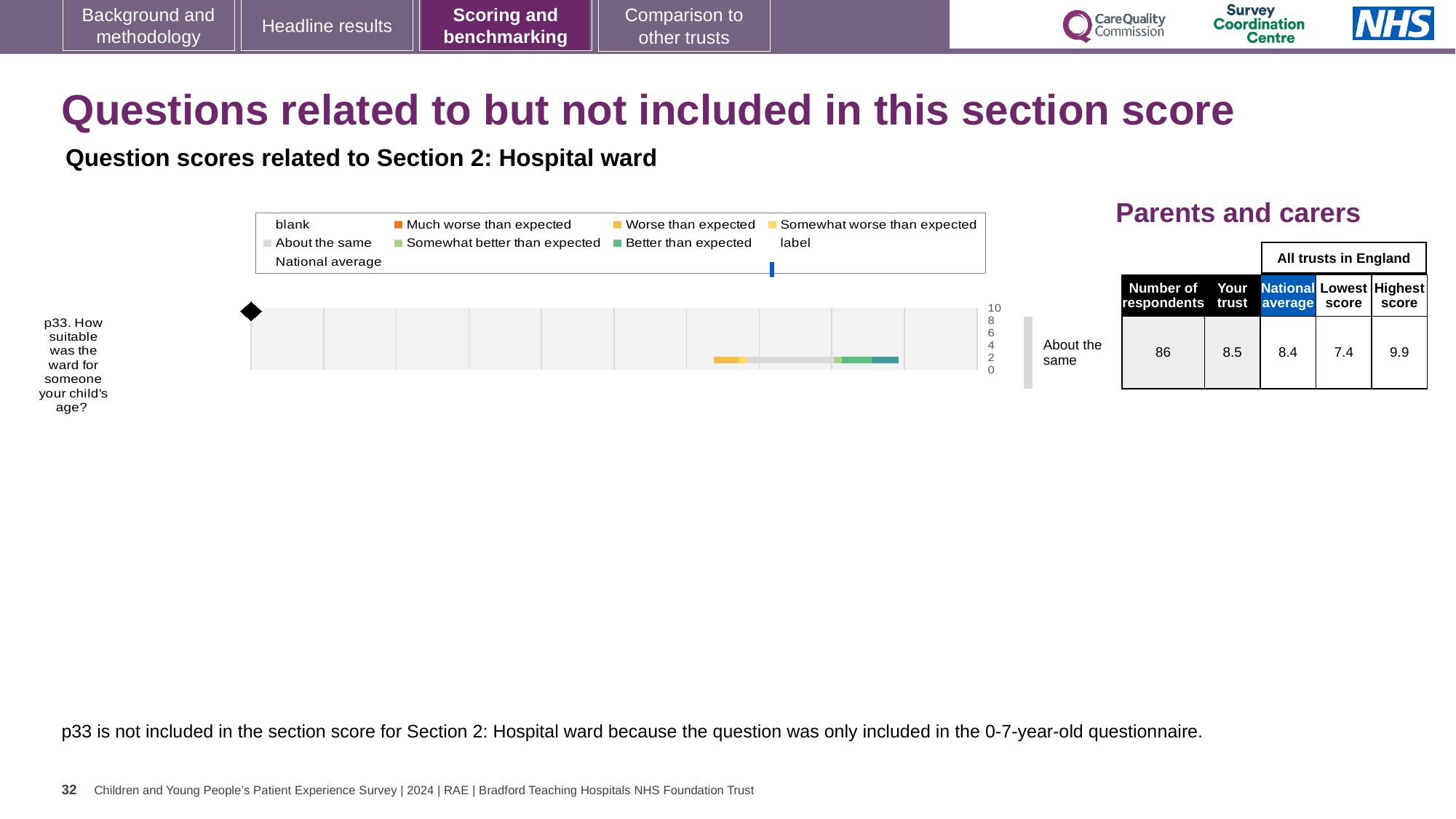
What is the highest score among all trusts in England for p33? 9.9 What is the 'Your trust' score for p33 in the Parents and carers table? 8.5 Which question is plotted in the chart? p33. How suitable was the ward for someone your child's age? What is the difference between the highest and lowest scores for p33 across all trusts in England? 2.5 What is the lowest score among all trusts in England for p33? 7.4 What is the national average score for p33? 8.4 How many questions are plotted in the chart? 1 Which is higher for p33, the 'Your trust' score or the national average? Your trust What kind of chart is used to show the p33 question score? Bar chart By how much does the 'Your trust' score for p33 exceed the national average? 0.1 What benchmark category label is shown to the right of the p33 bar? About the same How many respondents answered p33? 86